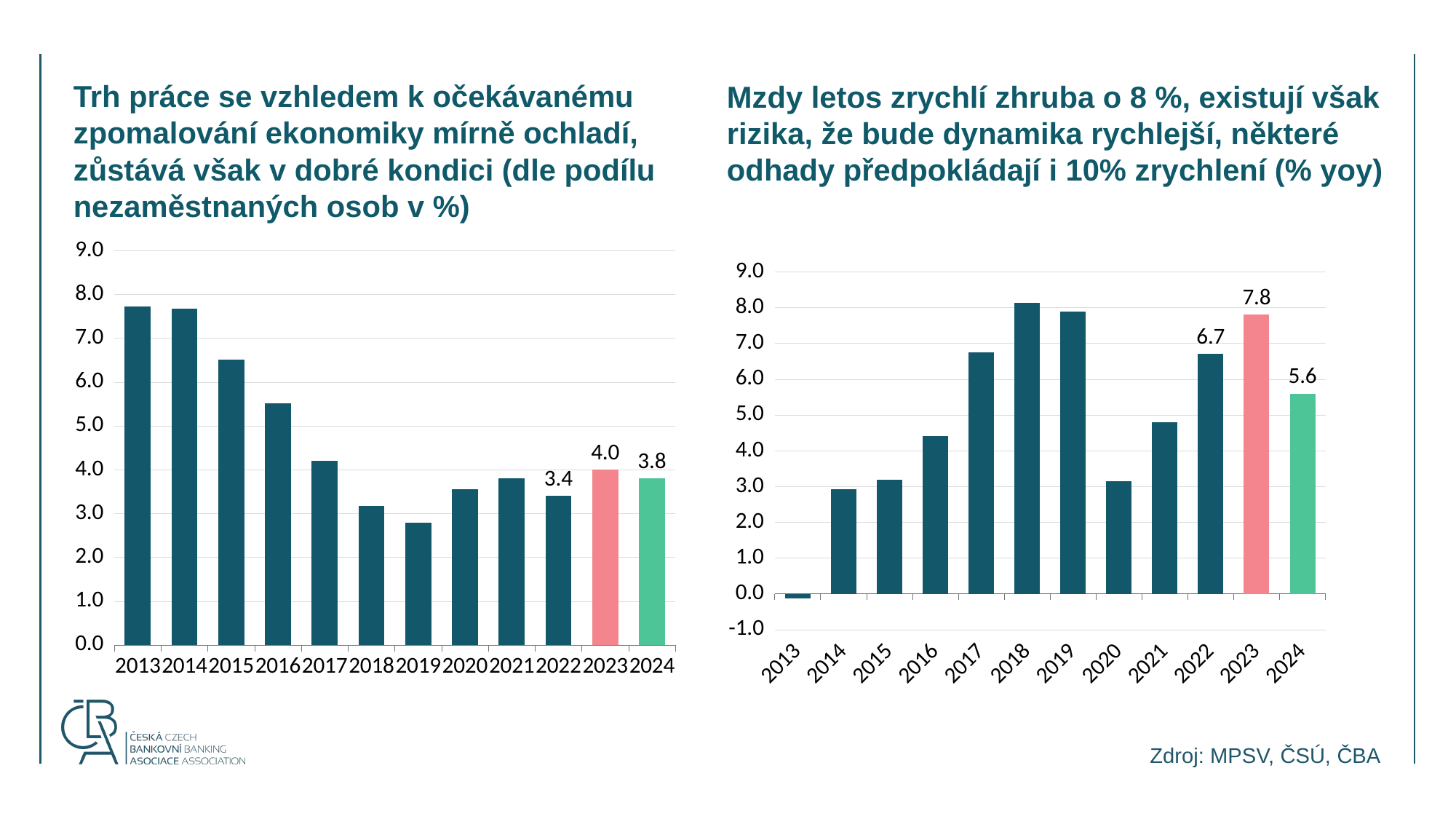
In the left chart (unemployment share), which year has the lowest value? 2019 In the right chart (wages, % yoy), what is the difference between the 2023 and 2022 values? 1.1 What type of chart is the right chart (wages, % yoy)? bar chart In the left chart (unemployment share), what is the value for 2023? 4.0 In the left chart (unemployment share), what is the value for 2022? 3.4 In the right chart (wages, % yoy), is the value for 2017 greater or less than 6.0? greater In the left chart (unemployment share), what is the difference between the 2023 and 2024 values? 0.2 How many years are shown on the x axis of the left chart? 12 In the right chart (wages, % yoy), what is the value for 2023? 7.8 In the left chart (unemployment share), is the value for 2015 greater or less than 6.0? greater In the right chart (wages, % yoy), what is the value for 2024? 5.6 In the right chart (wages, % yoy), which year has the lowest value? 2013